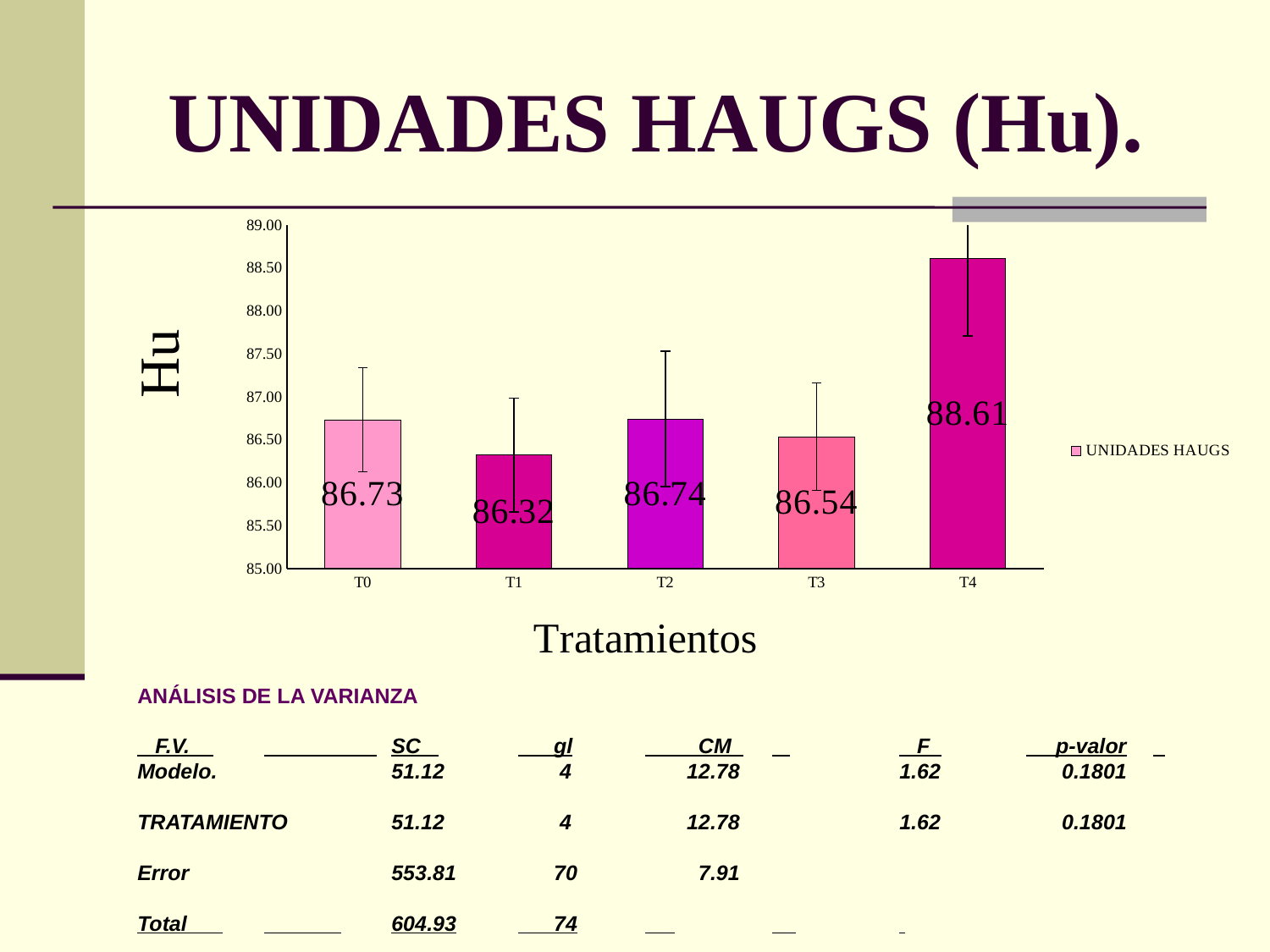
What is the difference between the values for T4 and T1? 2.29 What kind of chart is shown? bar chart What is the value for T4? 88.61 Which treatment has the lowest value? T1 Is the value for T4 greater or less than 88.00? greater What is the value for T3? 86.54 What is the label on the y axis? Hu What is the value for T1? 86.32 How many treatments are shown on the x axis? 5 Which treatment has the highest value? T4 Which is larger, the value for T4 or the value for T3? T4 What is the difference between the values for T0 and T3? 0.19